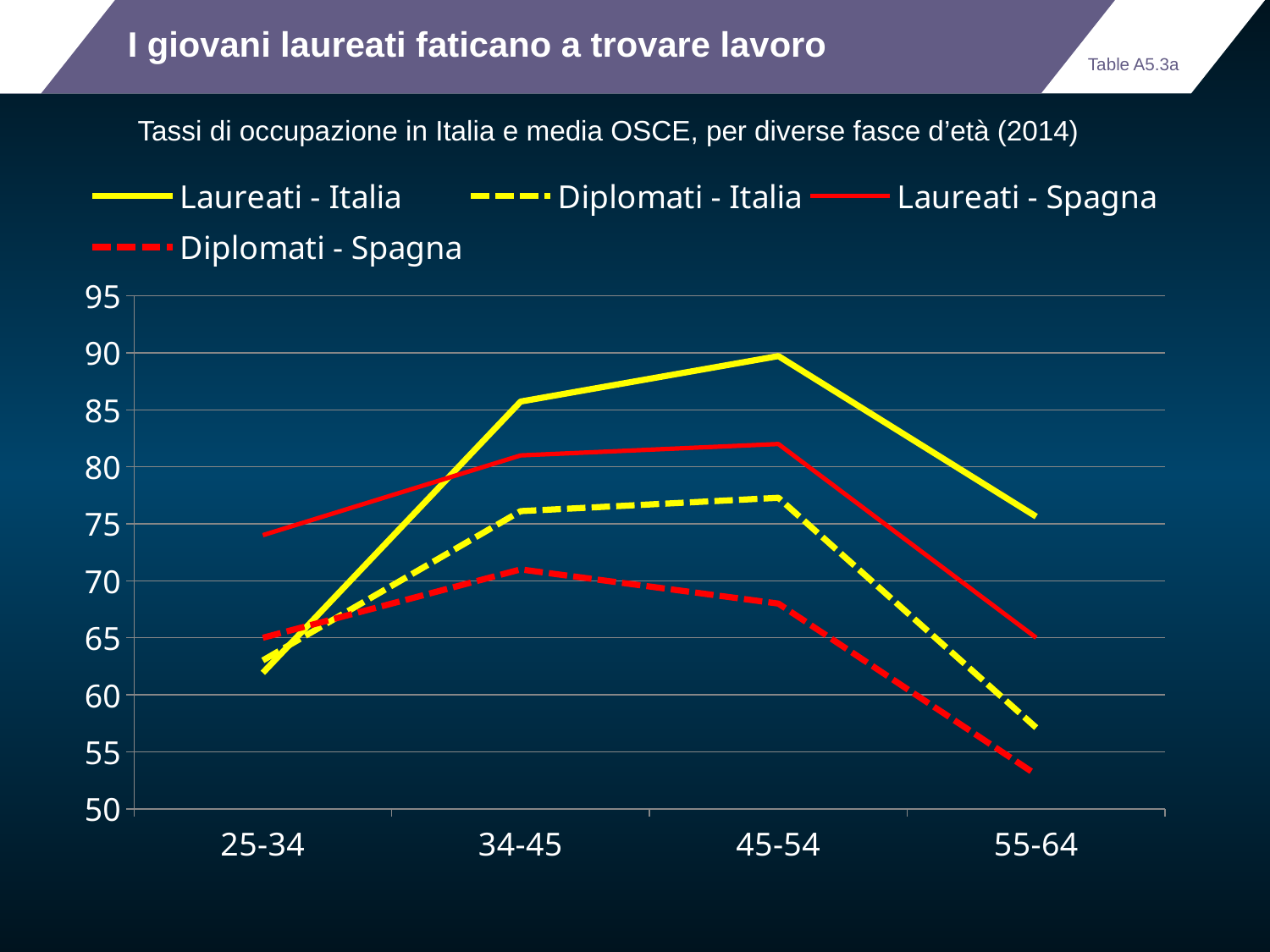
In the 25-34 age group, which is higher: Laureati - Italia or Laureati - Spagna? Laureati - Spagna What kind of chart is shown on the slide? Line chart In the 55-64 age group, which is higher: Laureati - Italia or Laureati - Spagna? Laureati - Italia How many age groups are shown on the x axis? 4 Is the value for Diplomati - Spagna in the 55-64 age group greater or less than 55? less Is the value for Laureati - Spagna in the 25-34 age group greater or less than 70? greater In which age group is the Laureati - Italia series at its lowest? 25-34 Which series has the lowest value in the 55-64 age group? Diplomati - Spagna Does the Laureati - Spagna series rise or fall from the 45-54 to the 55-64 age group? Falls How many series does the legend list? 4 In which age group does the Laureati - Italia series reach its highest value? 45-54 Is the value for Laureati - Italia in the 45-54 age group greater or less than 85? greater